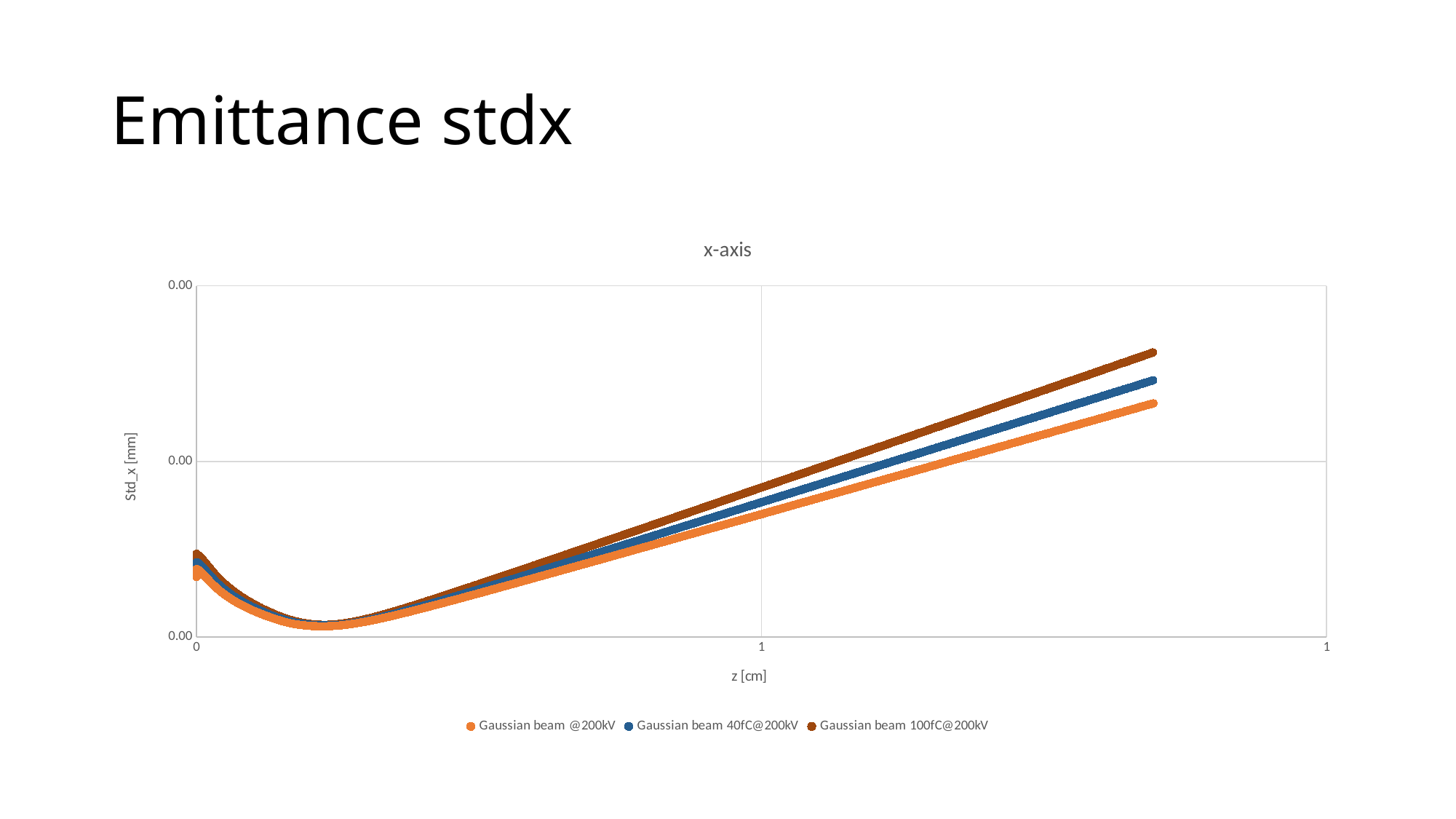
Do the values of the Gaussian beam @200kV series rise or fall immediately after the start of the x axis? fall What is the label of the vertical axis? Std_x [mm] What kind of chart is shown on the slide? line chart Which series has the lowest value at the right end of the plotted lines? Gaussian beam @200kV Which series has the highest value at the right end of the plotted lines? Gaussian beam 100fC@200kV At the right end of the plotted lines, which is larger: Gaussian beam 40fC@200kV or Gaussian beam @200kV? Gaussian beam 40fC@200kV Do the values of the Gaussian beam 100fC@200kV series rise or fall over the right half of the x axis? rise At the right end of the plotted lines, which is larger: Gaussian beam 100fC@200kV or Gaussian beam 40fC@200kV? Gaussian beam 100fC@200kV How many series does the legend list? 3 What is the title of the chart? x-axis